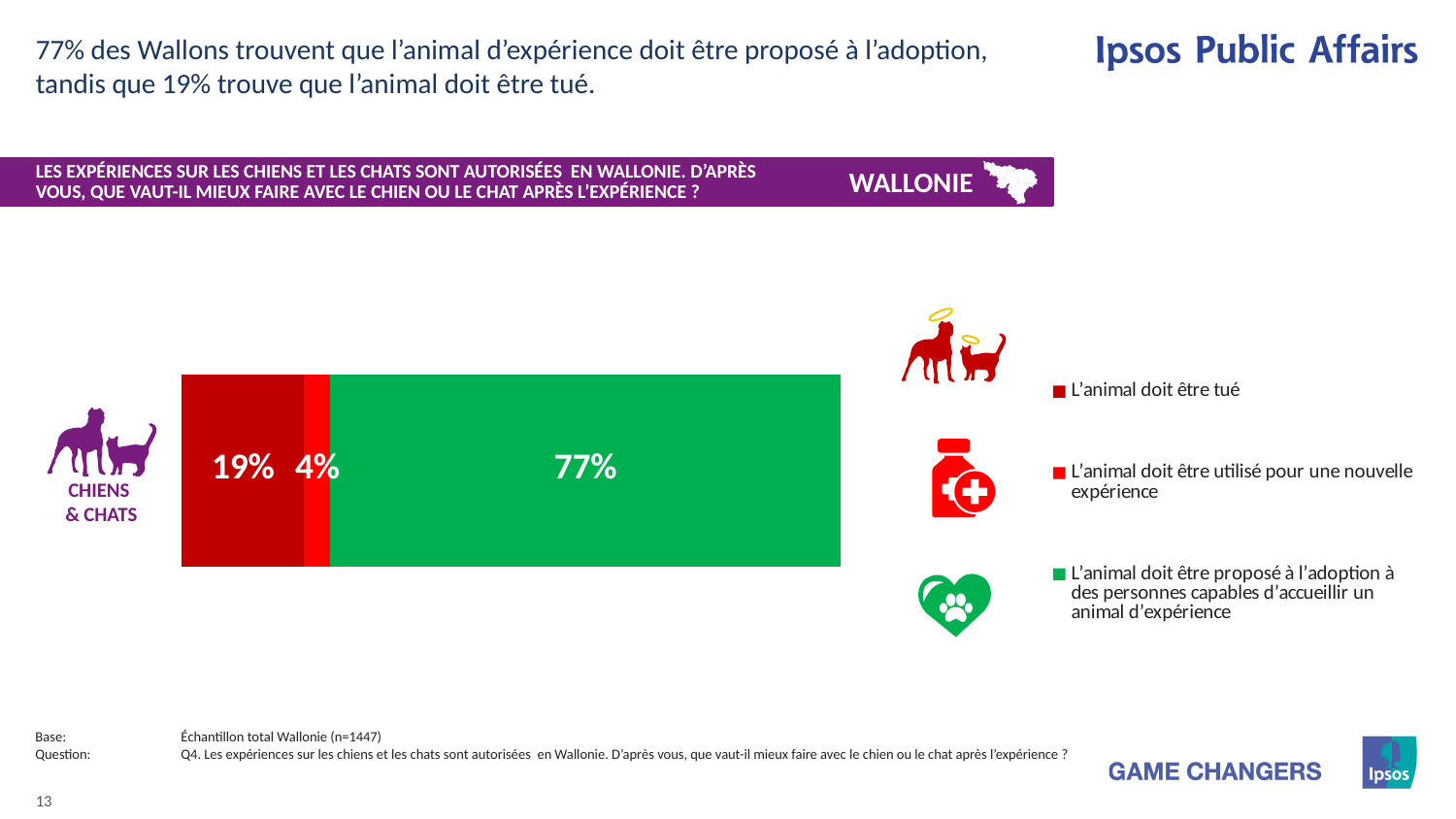
What is the total of the three segments in the stacked bar? 100% What percentage of respondents say the animal should be killed (L'animal doit être tué)? 19% Which response option has the lowest share in the bar? L'animal doit être utilisé pour une nouvelle expérience How many series does the legend list? 3 What is the category label shown to the left of the bar? CHIENS & CHATS Which is larger: the share saying the animal should be killed or the share saying it should be used for a new experiment? L'animal doit être tué What percentage of respondents say the animal should be used for a new experiment (L'animal doit être utilisé pour une nouvelle expérience)? 4% What percentage of respondents say the animal should be offered for adoption (L'animal doit être proposé à l'adoption)? 77% Which response option has the highest share in the bar? L'animal doit être proposé à l'adoption à des personnes capables d'accueillir un animal d'expérience What is the difference in percentage points between the share for adoption (77%) and the share for the animal being killed (19%)? 58 What kind of chart is shown on the slide? Stacked bar chart What colour is the segment representing 'L'animal doit être proposé à l'adoption'? Green